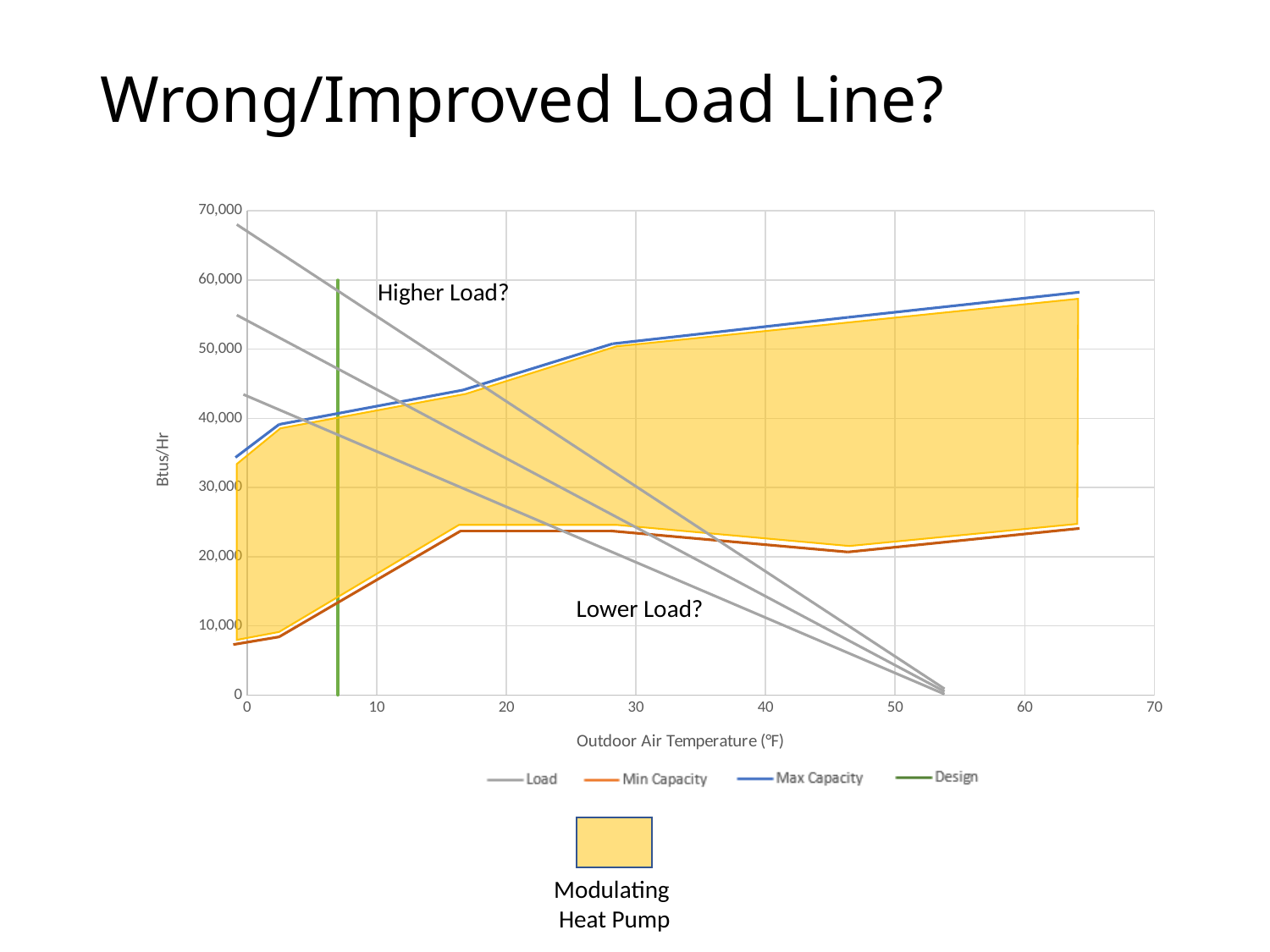
What kind of chart is shown on the slide? line chart Is the Min Capacity value at 40°F greater or less than 30,000? less Is the Max Capacity value at 60°F greater or less than 50,000? greater How many series does the chart legend list? 4 Does the Max Capacity line rise or fall as outdoor air temperature increases? rise Is the Min Capacity value at 0°F greater or less than 10,000? less How many gray Load lines are drawn on the chart? 3 What is the label of the chart's x axis? Outdoor Air Temperature (°F) What is the title of the slide containing the chart? Wrong/Improved Load Line? Do the gray Load lines rise or fall as outdoor air temperature increases? fall At 30°F, which is larger: Max Capacity or Min Capacity? Max Capacity